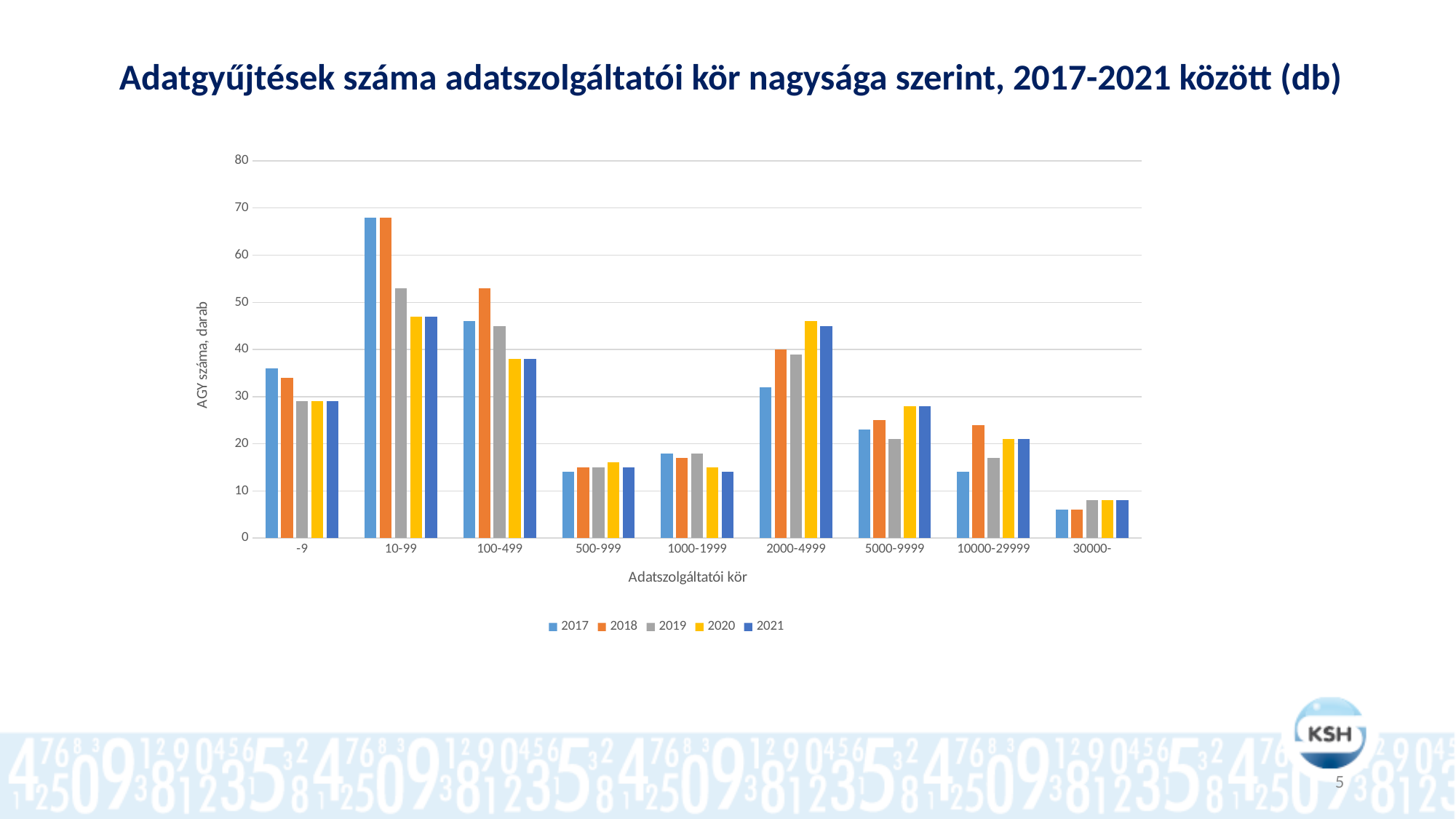
Is the 2021 value for 30000- greater or less than 10? less For the 100-499 category, which is larger: the 2018 value or the 2017 value? 2018 What kind of chart is shown on the slide? bar chart Which category has the lowest value for the 2021 series? 30000- Is the 2018 value for 100-499 greater or less than 50? greater What is the label of the y axis? AGY száma, darab Is the 2017 value for 10-99 greater or less than 60? greater How many categories are shown on the x axis? 9 How many series does the legend list? 5 Which category has the highest value for the 2019 series? 10-99 For the 2000-4999 category, which is larger: the 2020 value or the 2017 value? 2020